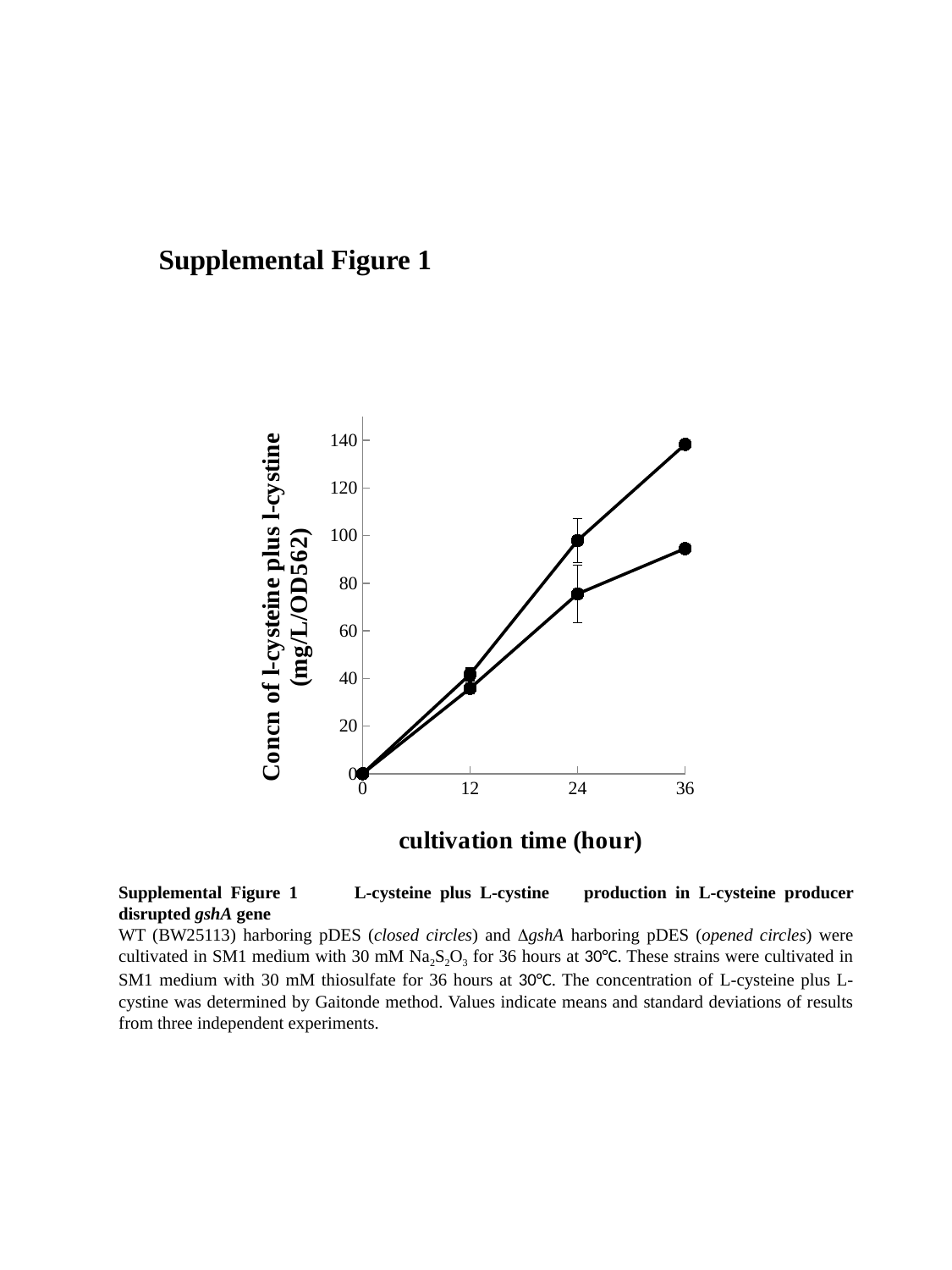
At 36 hours, is the higher of the two plotted values greater or less than 120? greater How many cultivation time points are plotted along the x axis? 4 What is the highest tick value shown on the y axis? 140 At 12 hours, are the plotted values greater or less than 60? less What is the label of the x axis? cultivation time (hour) At 24 hours, is the higher of the two plotted values greater or less than 80? greater How many lines are plotted on the chart? 2 What kind of chart is shown on the slide? line chart What is the plotted value for both lines at 0 hours? 0 Do the plotted values rise or fall as cultivation time increases from 0 to 36 hours? rise